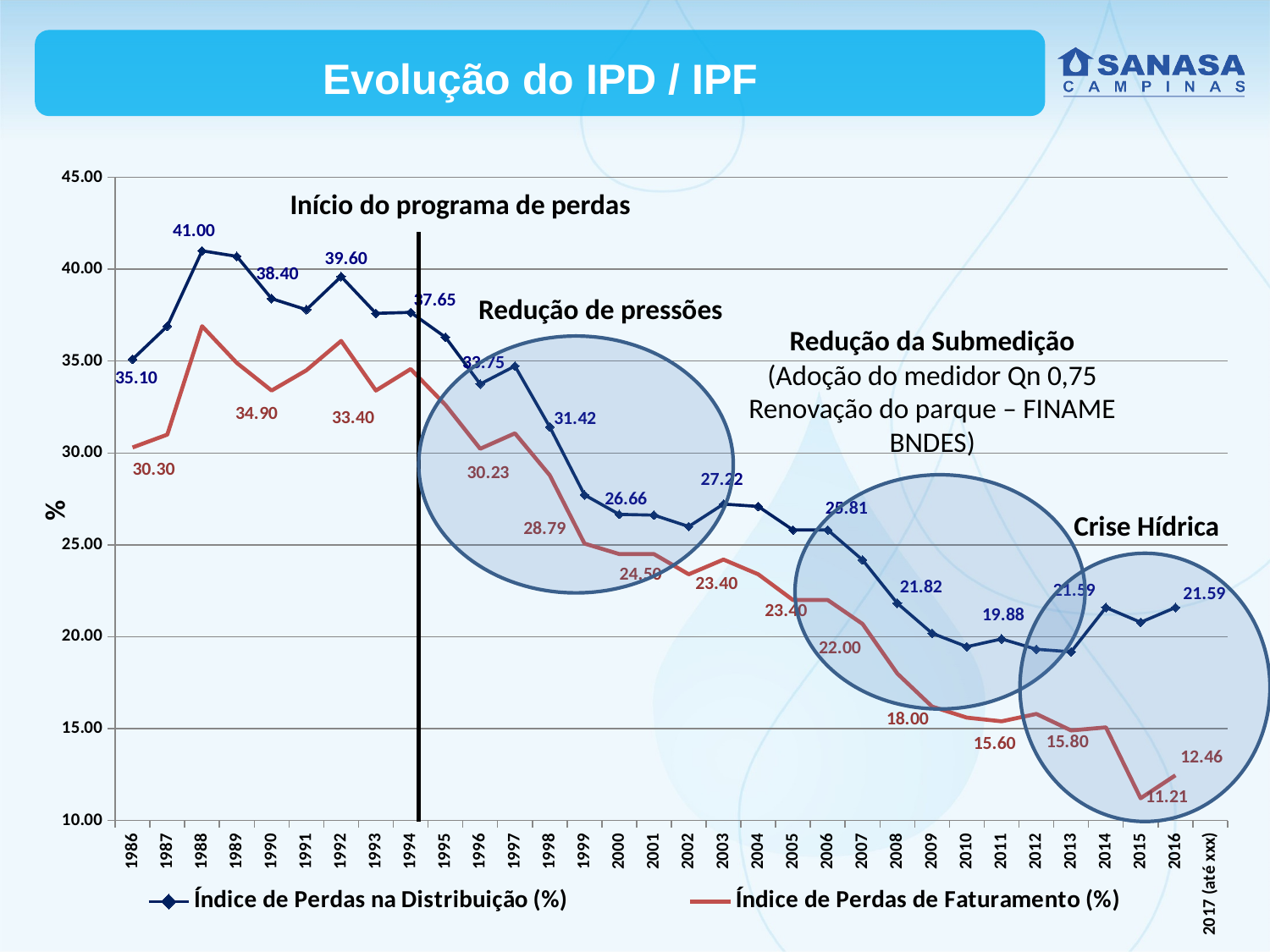
What is the value of Índice de Perdas de Faturamento (%) in 2016? 12.46 What is the lowest labelled value of Índice de Perdas de Faturamento (%), and in which year does it occur? 11.21 in 2015 What is the value of Índice de Perdas na Distribuição (%) in 2016? 21.59 What is the value of Índice de Perdas de Faturamento (%) in 1986? 30.30 How many series does the legend list? 2 What is the highest labelled value of Índice de Perdas na Distribuição (%), and in which year does it occur? 41.00 in 1988 What is the difference between Índice de Perdas na Distribuição (%) and Índice de Perdas de Faturamento (%) in 2016? 9.13 Is the value of Índice de Perdas na Distribuição (%) in 2004 greater or less than 25.00? greater In 1986, which series has the higher value: Índice de Perdas na Distribuição (%) or Índice de Perdas de Faturamento (%)? Índice de Perdas na Distribuição (%) What kind of chart is shown on the slide? line chart Overall, does Índice de Perdas na Distribuição (%) rise or fall from 1986 to 2016? fall What is the value of Índice de Perdas na Distribuição (%) in 1986? 35.10